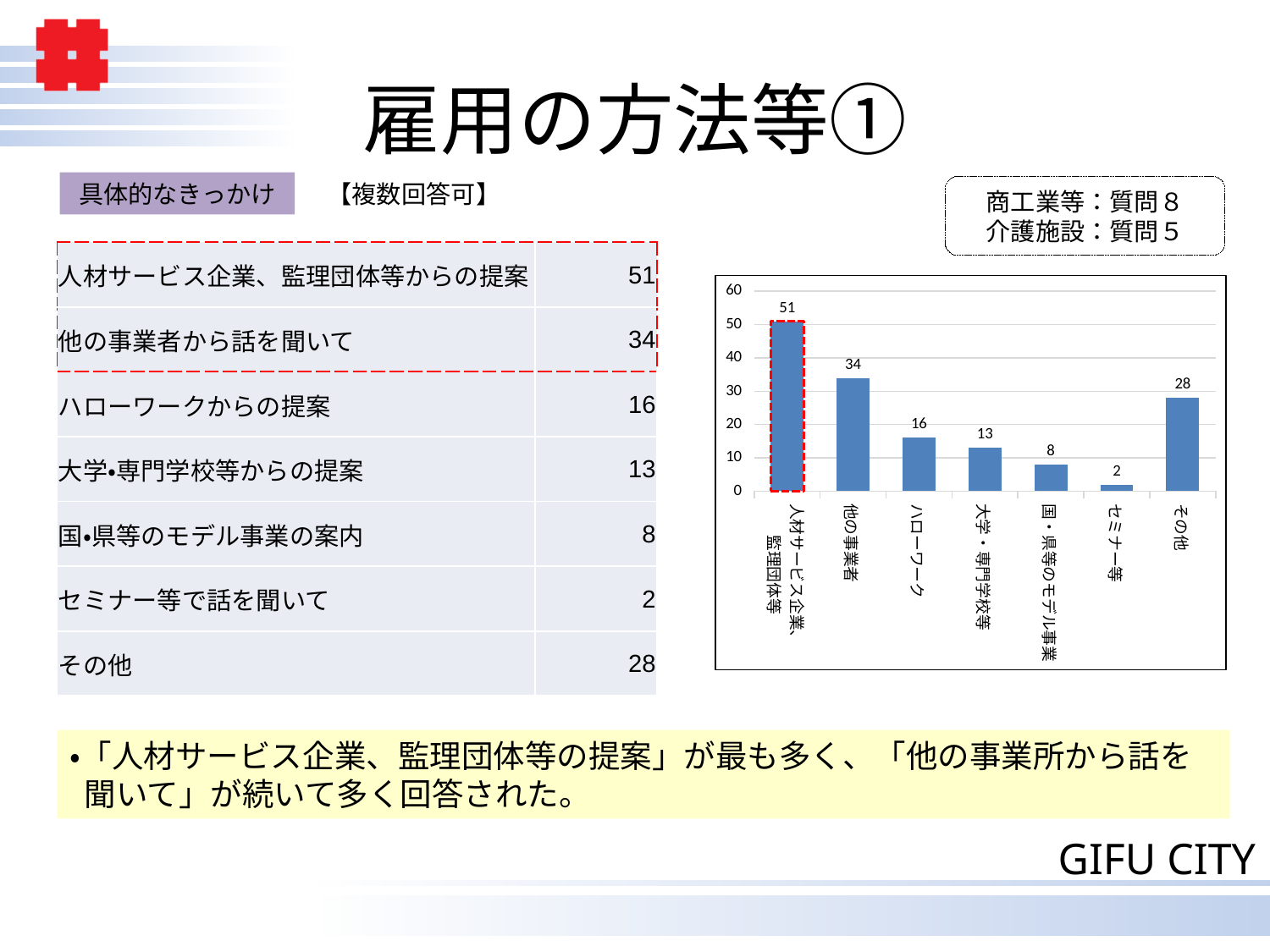
Which category has the lowest value in the bar chart? セミナー等 What kind of chart is shown on the slide? bar chart Which is larger, the value for 大学・専門学校等 or the value for その他? その他 What is the highest value shown on the vertical axis of the chart? 60 What is the value for ハローワーク in the bar chart? 16 Is the value for 人材サービス企業、監理団体等 greater or less than 40? greater What is the difference between the values for 人材サービス企業、監理団体等 and 他の事業者? 17 What is the value for 他の事業者 in the bar chart? 34 What is the difference between the values for その他 and 国・県等のモデル事業? 20 What is the value for その他 in the bar chart? 28 How many categories are shown in the bar chart? 7 Which category has the highest value in the bar chart? 人材サービス企業、監理団体等